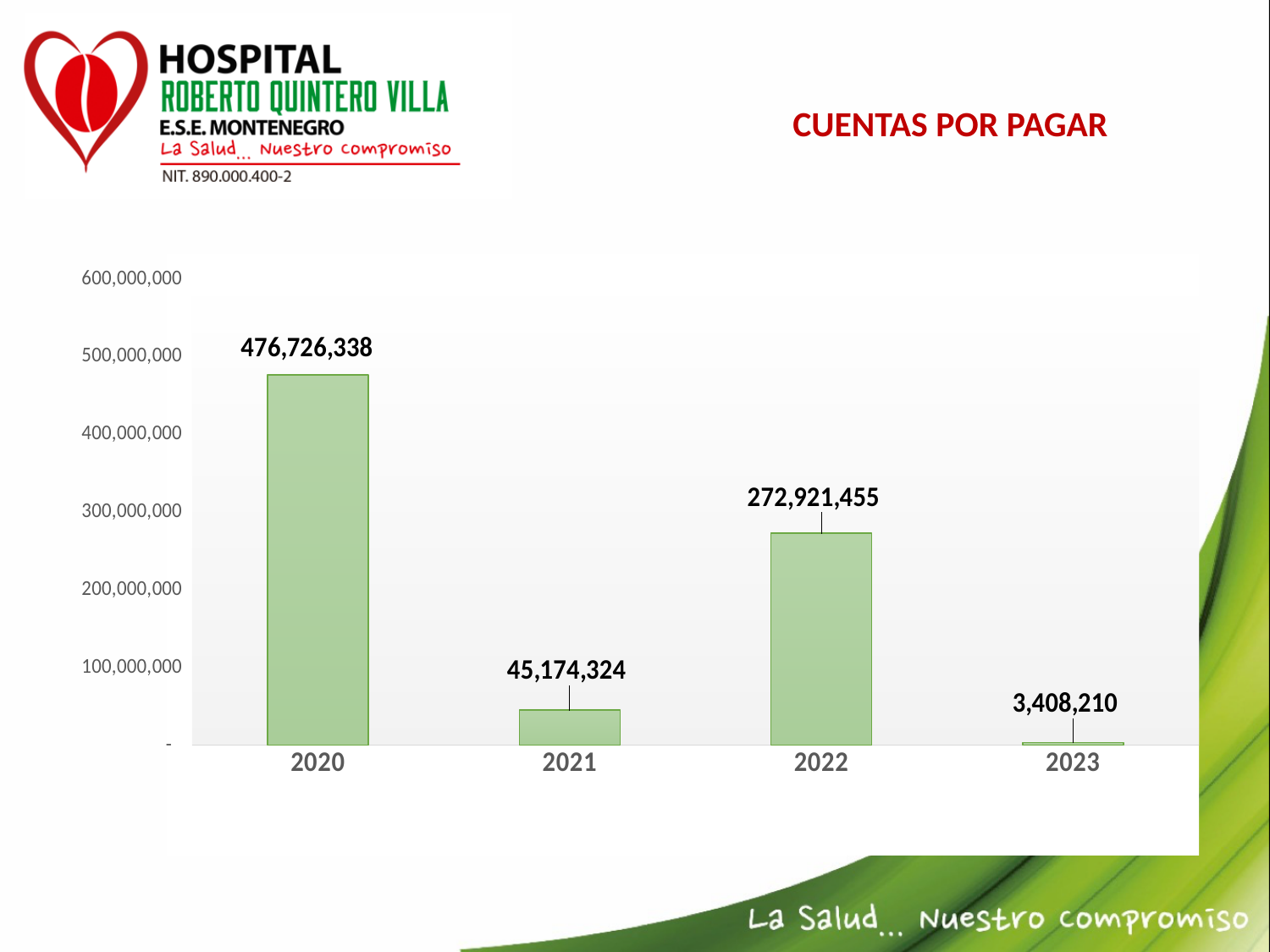
Which is larger, the value for 2021 or the value for 2022? 2022 What is the value for 2022 in the CUENTAS POR PAGAR chart? 272,921,455 Which year has the lowest value in the CUENTAS POR PAGAR chart? 2023 What is the value for 2023 in the CUENTAS POR PAGAR chart? 3,408,210 What kind of chart is shown on the slide? Bar chart Does the value fall or rise from 2020 to 2021? Fall What is the difference between the values for 2021 and 2023? 41,766,114 What is the difference between the values for 2020 and 2022? 203,804,883 How many years are shown on the x axis of the chart? 4 Which year has the highest value in the CUENTAS POR PAGAR chart? 2020 What is the value for 2020 in the CUENTAS POR PAGAR chart? 476,726,338 What is the value for 2021 in the CUENTAS POR PAGAR chart? 45,174,324